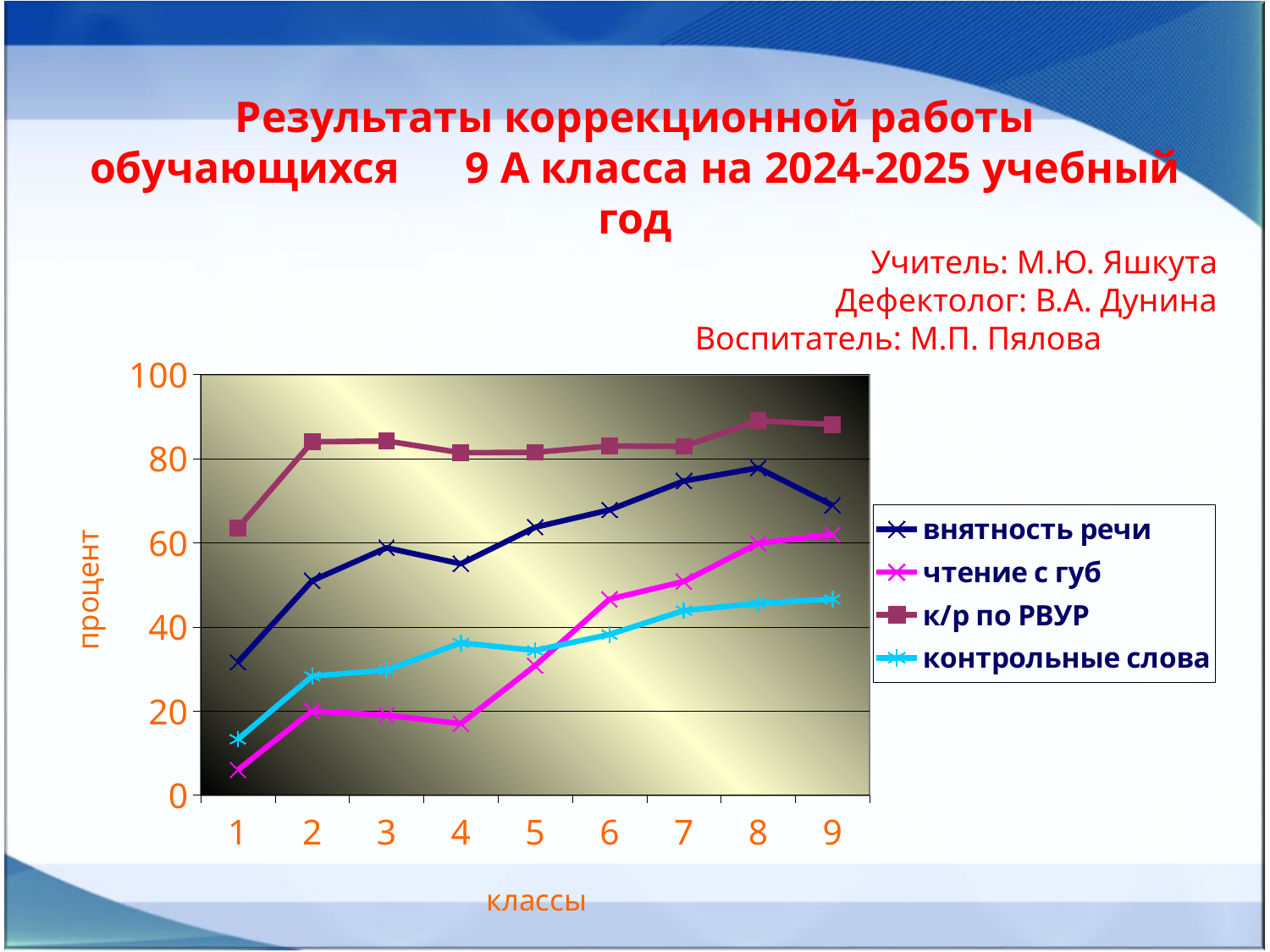
Is the value for к/р по РВУР at class 8 greater or less than 80? greater Is the value for чтение с губ at class 1 greater or less than 20? less How many classes (categories) are plotted along the x axis? 9 How many series does the legend list? 4 Which series has the highest value at class 9? к/р по РВУР What is the title of the vertical axis? процент Does the чтение с губ line rise or fall from class 5 to class 9? rise What kind of chart is shown on the slide? line chart At class 5, which is larger: внятность речи or контрольные слова? внятность речи Which series has the lowest value at class 1? чтение с губ Is the value for контрольные слова at class 9 greater or less than 60? less